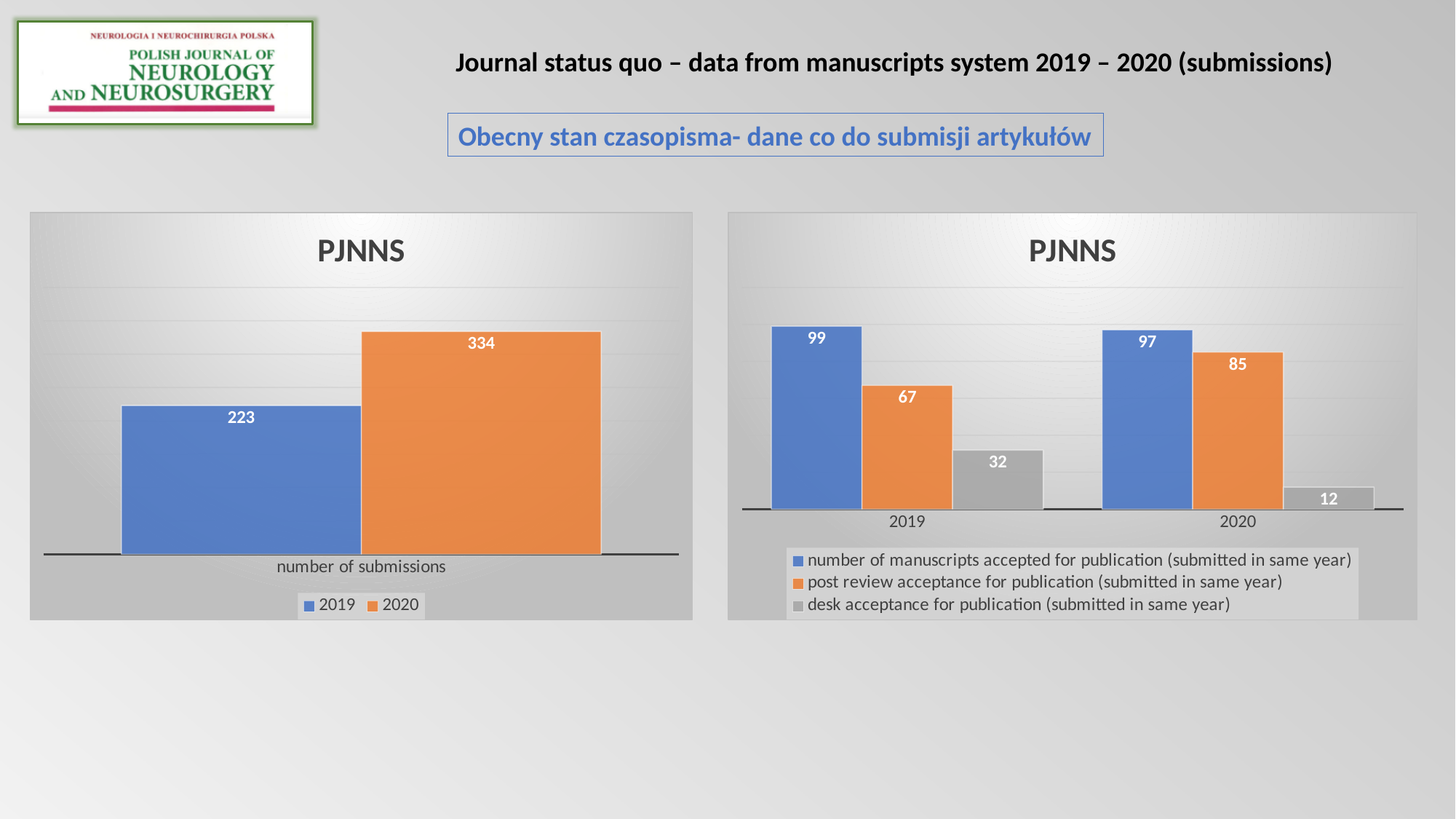
In the right chart, how many series does the legend list? 3 In the right chart, what is the post review acceptance for publication value for 2020? 85 In the right chart, what is the difference between desk acceptance for publication in 2019 and 2020? 20 In the left chart, what is the difference between the 2020 and 2019 number of submissions? 111 In the left chart, what is the number of submissions for 2020? 334 In the right chart, what is the number of manuscripts accepted for publication (submitted in same year) in 2019? 99 In the right chart, what is the desk acceptance for publication value for 2019? 32 In the left chart, which year has the higher number of submissions? 2020 In the right chart, which series has the lowest value in 2020? desk acceptance for publication (submitted in same year) In the left chart, what is the number of submissions for 2019? 223 In the left chart, how many series does the legend list? 2 What type of chart is the right chart? bar chart